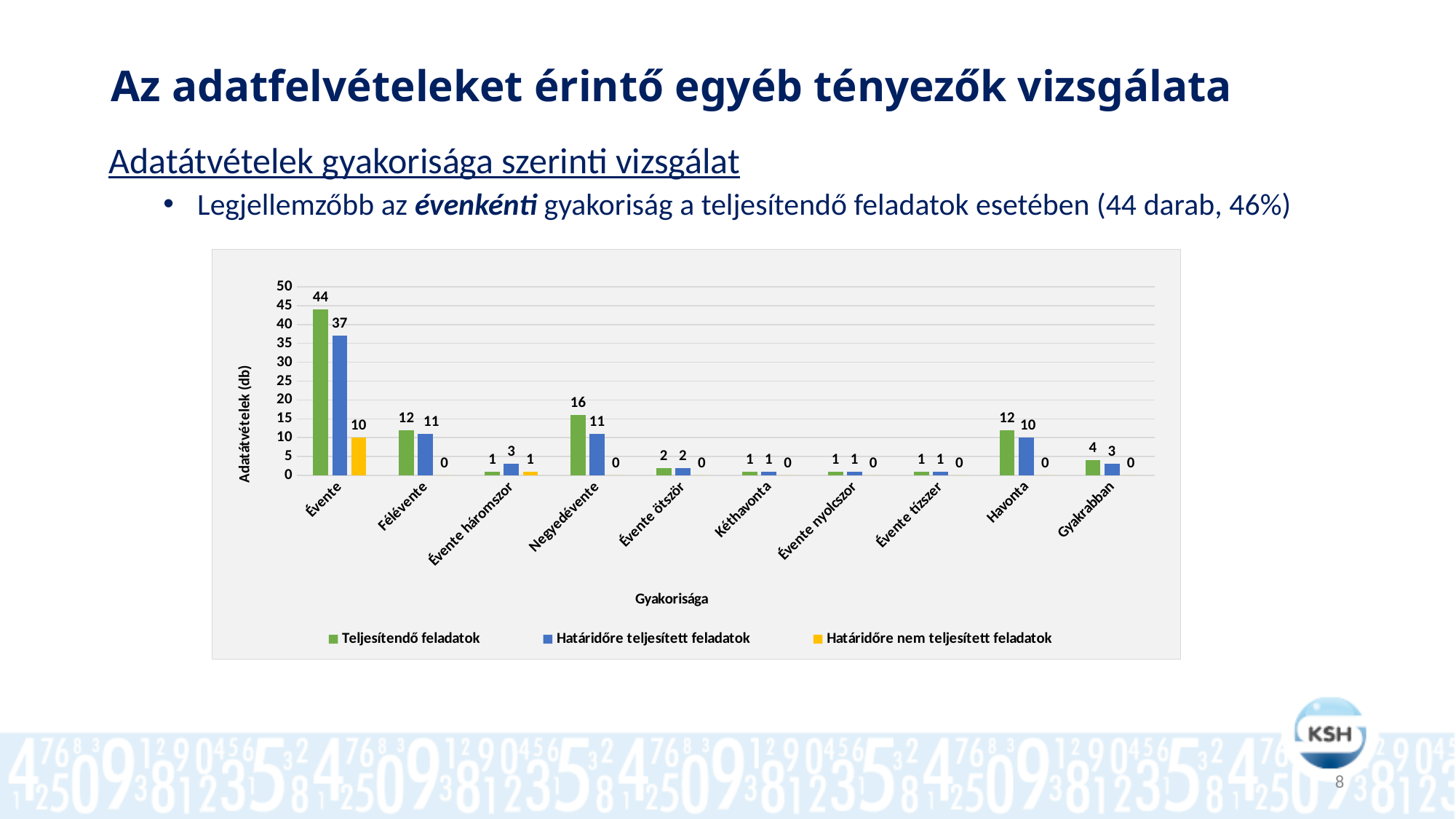
Which category has the highest value for Teljesítendő feladatok? Évente Which is larger for Havonta: Teljesítendő feladatok or Határidőre teljesített feladatok? Teljesítendő feladatok What is the value of Teljesítendő feladatok for Évente? 44 What is the value of Határidőre teljesített feladatok for Negyedévente? 11 How many categories are shown on the x axis? 10 What is the value of Teljesítendő feladatok for Gyakrabban? 4 How many series does the legend list? 3 What is the label of the y axis? Adatátvételek (db) What is the difference between Teljesítendő feladatok and Határidőre teljesített feladatok for Évente? 7 What kind of chart is shown on the slide? bar chart What is the value of Határidőre teljesített feladatok for Évente háromszor? 3 What is the value of Határidőre nem teljesített feladatok for Évente? 10